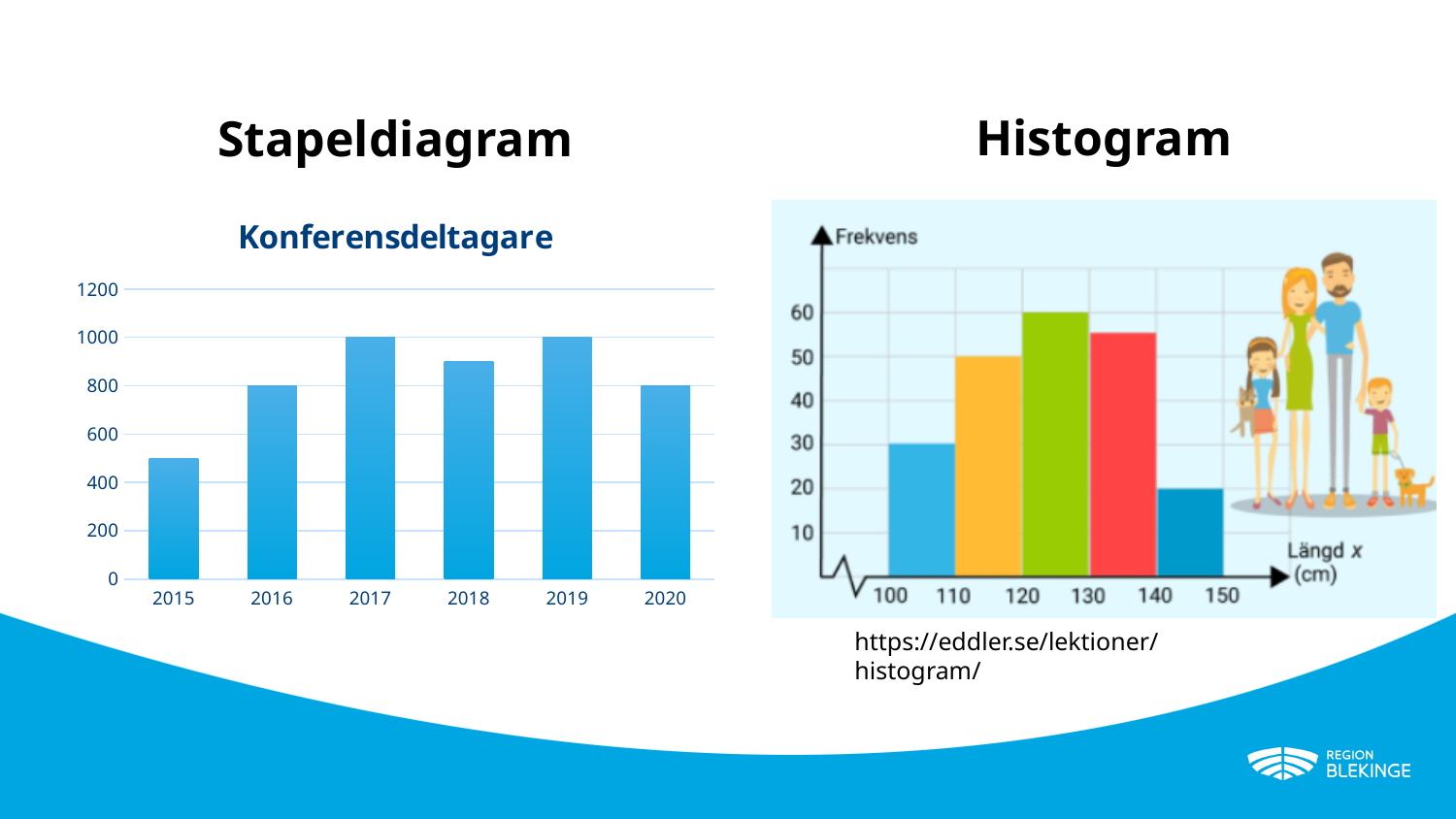
In the Histogram on the right, what is the frequency for the 140–150 cm interval? 20 In the Histogram on the right, what is the label of the vertical axis? Frekvens In the Konferensdeltagare chart, what is the difference between the values for 2017 and 2016? 200 In the Konferensdeltagare chart, is the value for 2018 greater or less than 800? greater In the Konferensdeltagare chart, is the value for 2015 greater or less than 600? less In the Konferensdeltagare chart, what is the value for 2017? 1000 In the Histogram on the right, which length interval has the highest frequency? 120–130 cm In the Konferensdeltagare chart, which year has the lowest value? 2015 In the Konferensdeltagare chart, which is larger, the value for 2016 or the value for 2018? 2018 What kind of chart is the Konferensdeltagare chart? bar chart In the Konferensdeltagare chart, what is the value for 2020? 800 How many years are shown in the Konferensdeltagare chart? 6